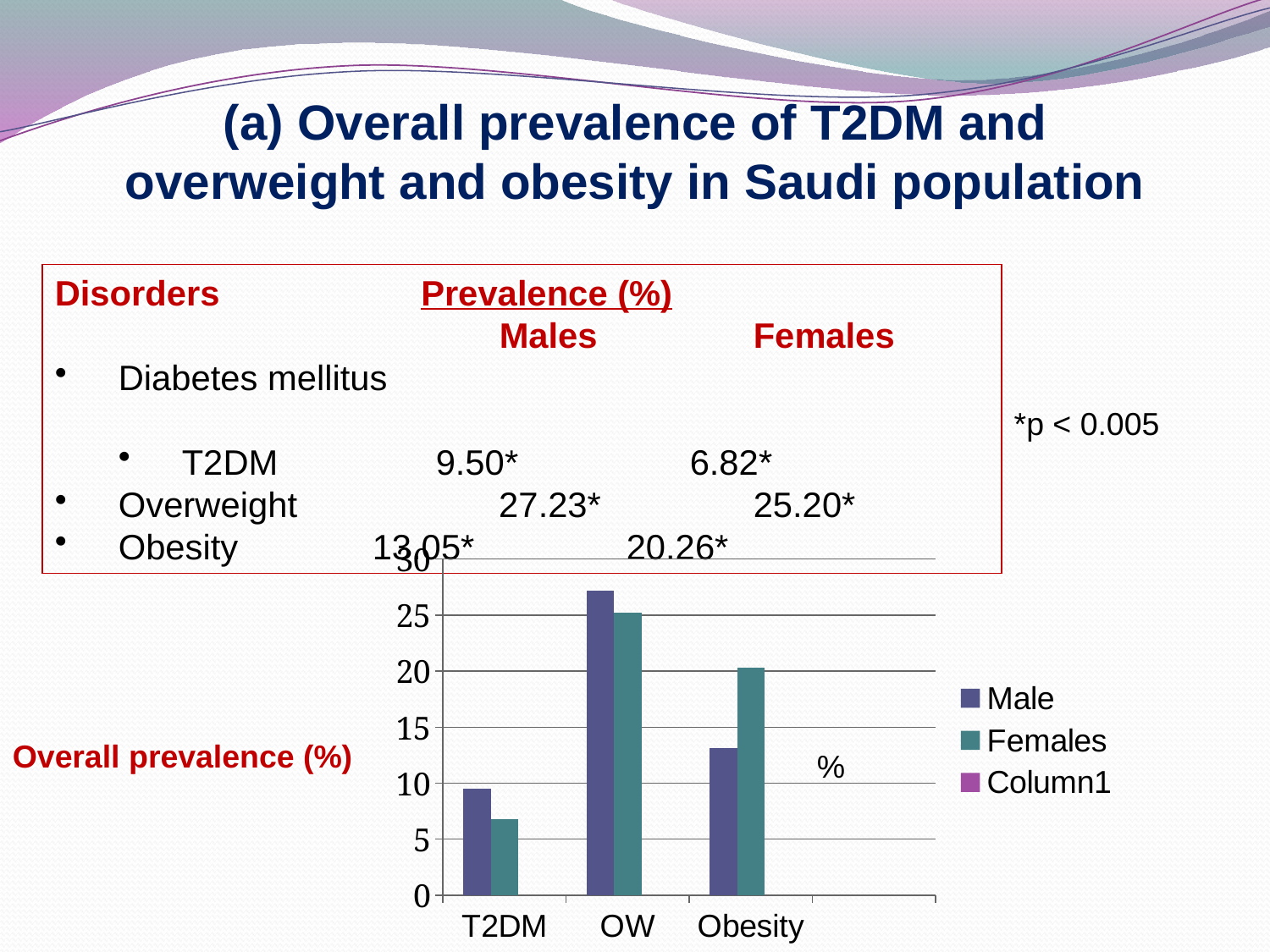
For OW, which is larger: the Male bar or the Females bar? Male How many series does the chart's legend list? 3 What kind of chart is shown on the slide? bar chart Is the Male value for Obesity greater or less than 15? less For T2DM, which is larger: the Male bar or the Females bar? Male Is the Females value for Obesity greater or less than 15? greater Which category has the highest Male bar in the chart? OW Which category has the lowest Females bar in the chart? T2DM Is the Male value for OW greater or less than 25? greater What are the three entries listed in the chart's legend? Male, Females, Column1 How many categories are shown on the x axis of the chart? 3 For Obesity, which is larger: the Male bar or the Females bar? Females